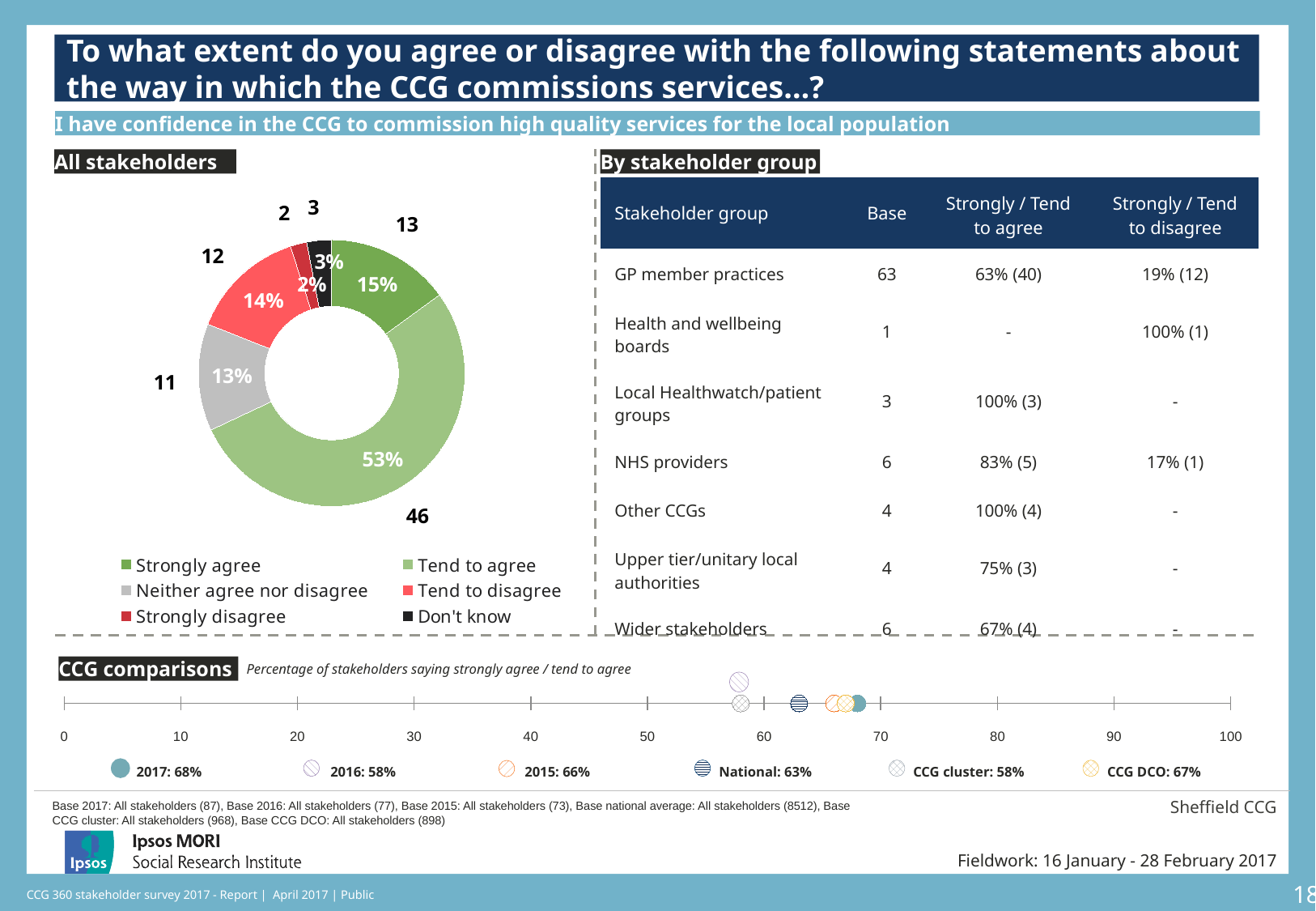
In the All stakeholders chart, what percentage of stakeholders said 'Strongly agree'? 15% What kind of chart is the All stakeholders chart? Pie (donut) chart In the All stakeholders chart, which response has the largest share? Tend to agree In the All stakeholders chart, what percentage of stakeholders said 'Tend to agree'? 53% In the All stakeholders chart, how many stakeholders said 'Tend to agree'? 46 In the All stakeholders chart, what is the difference in percentage points between 'Tend to disagree' and 'Neither agree nor disagree'? 1 percentage point In the All stakeholders chart, which response has the smallest share? Strongly disagree How many entries does the legend of the All stakeholders chart list? 6 In the CCG comparisons chart, what is the 2017 percentage of stakeholders saying strongly agree / tend to agree? 68% How many response categories are shown in the All stakeholders chart? 6 In the All stakeholders chart, what is the combined share of 'Strongly agree' and 'Tend to agree'? 68% In the CCG comparisons chart, which marker has the highest value? 2017: 68%